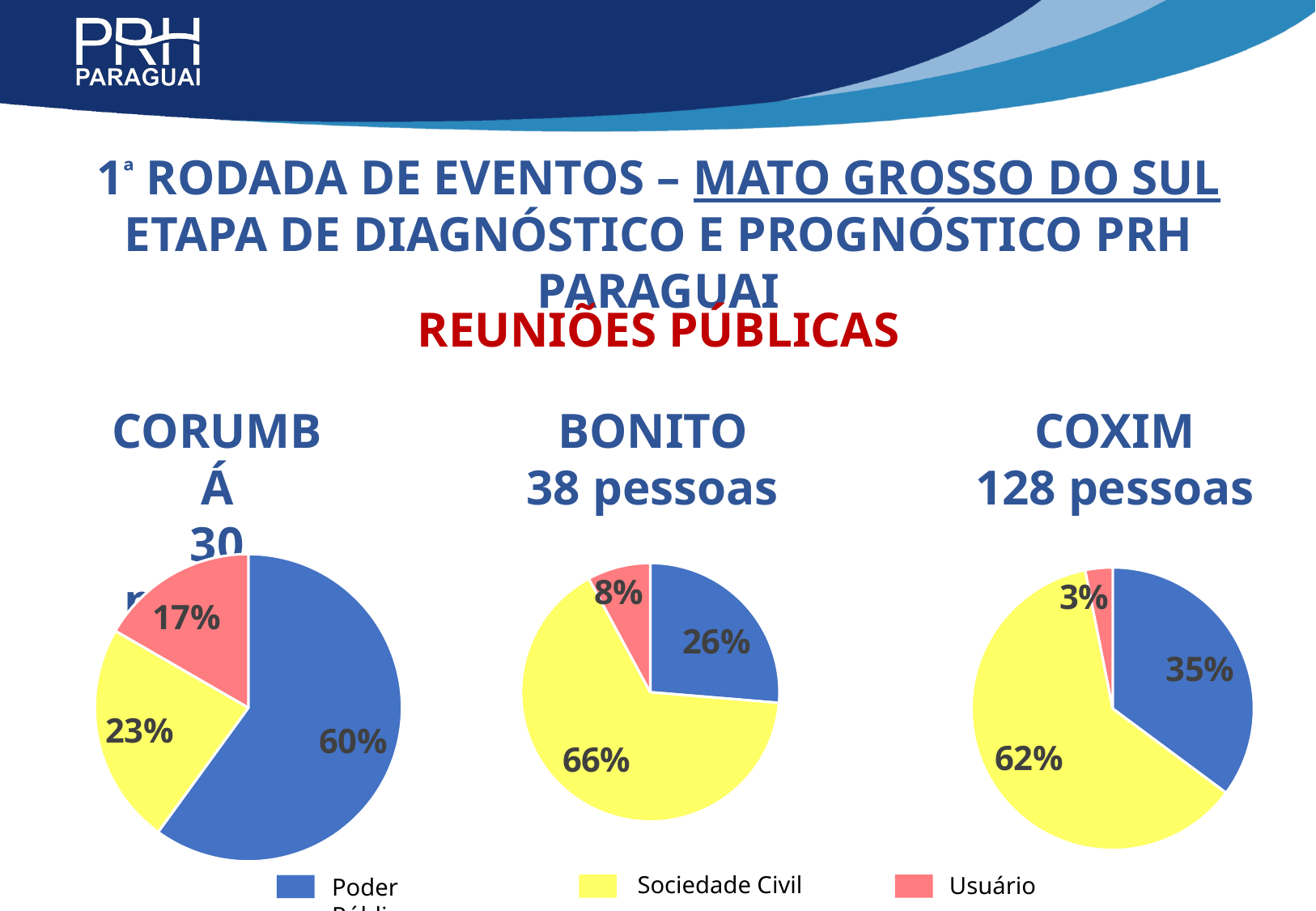
How many people attended the Coxim meeting according to the chart title? 128 pessoas In the Coxim pie chart, which category has the largest share? Sociedade Civil In the Coxim pie chart, what is the difference between the Sociedade Civil share and the blue (Poder Público) share? 27% How many slices does the Corumbá pie chart have? 3 In the Corumbá pie chart, what share is the blue (Poder Público) slice? 60% In the Coxim pie chart, what share is Usuário? 3% In the Bonito pie chart, which is larger: the Sociedade Civil share or the blue (Poder Público) share? Sociedade Civil In the Bonito pie chart, what share is Sociedade Civil? 66% What type of chart is used for Bonito? Pie chart In the Bonito pie chart, what share is Usuário? 8% In the Corumbá pie chart, which category has the smallest share? Usuário How many pie charts are shown on the slide? 3